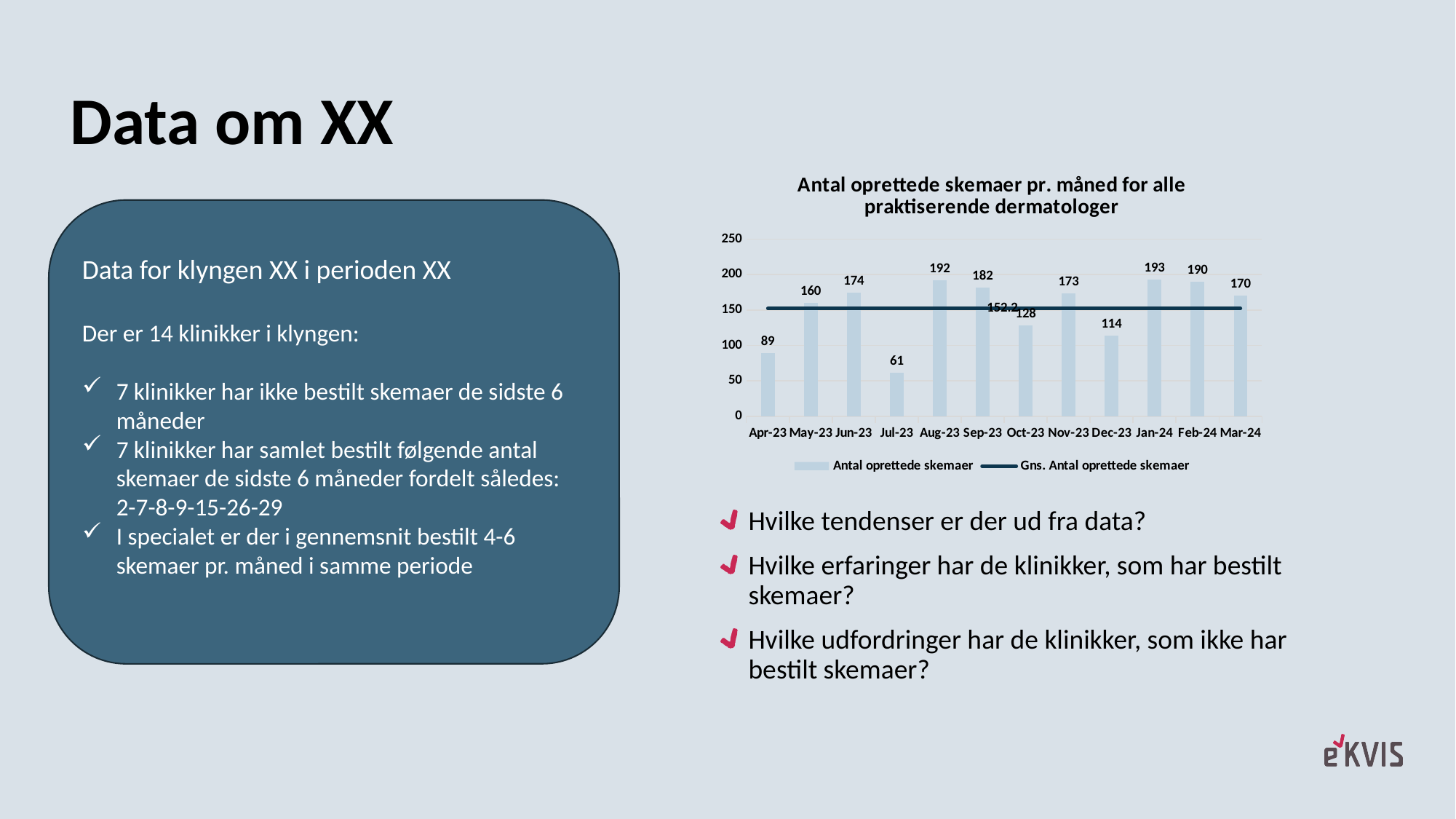
How many series does the chart legend list? 2 What is the difference between the values for Aug-23 and Jul-23? 131 What is the value for Aug-23 in the chart? 192 Which is larger, the value for Oct-23 or the value for Nov-23? Nov-23 Which month has the lowest number of created forms (Antal oprettede skemaer)? Jul-23 Is the value for Apr-23 greater or less than 100? less What value is shown for the average line (Gns. Antal oprettede skemaer)? 152.2 What kind of chart is used to show the monthly number of created forms? Bar chart What is the value for Dec-23 in the chart? 114 How many months are shown on the x axis of the chart? 12 What is the value for Jul-23 in the chart? 61 Which month has the highest number of created forms (Antal oprettede skemaer)? Jan-24